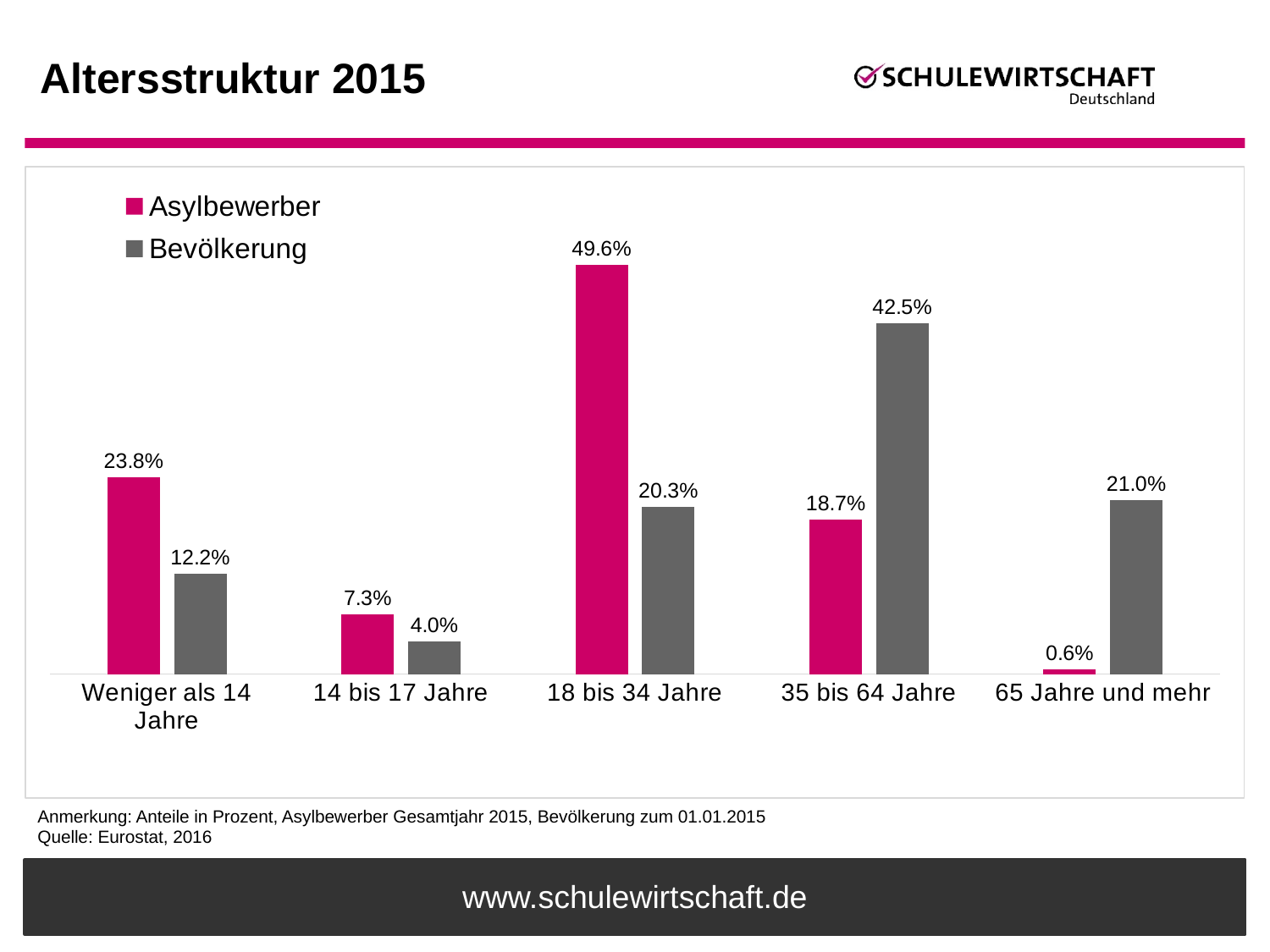
Which colour represents the Asylbewerber series? Magenta (pink) What kind of chart is shown on the slide? Bar chart What is the Bevölkerung value for the 65 Jahre und mehr category? 21.0% How many age categories are shown on the x axis? 5 What is the difference between the Asylbewerber and Bevölkerung values for the 18 bis 34 Jahre category? 29.3% What is the Asylbewerber value for the Weniger als 14 Jahre category? 23.8% Which category has the highest Bevölkerung value? 35 bis 64 Jahre Which is larger for the 35 bis 64 Jahre category, the Asylbewerber value or the Bevölkerung value? Bevölkerung What is the Asylbewerber value for the 18 bis 34 Jahre category? 49.6% What is the difference between the Asylbewerber and Bevölkerung values for the 14 bis 17 Jahre category? 3.3% How many series does the legend list? 2 Which category has the lowest Asylbewerber value? 65 Jahre und mehr